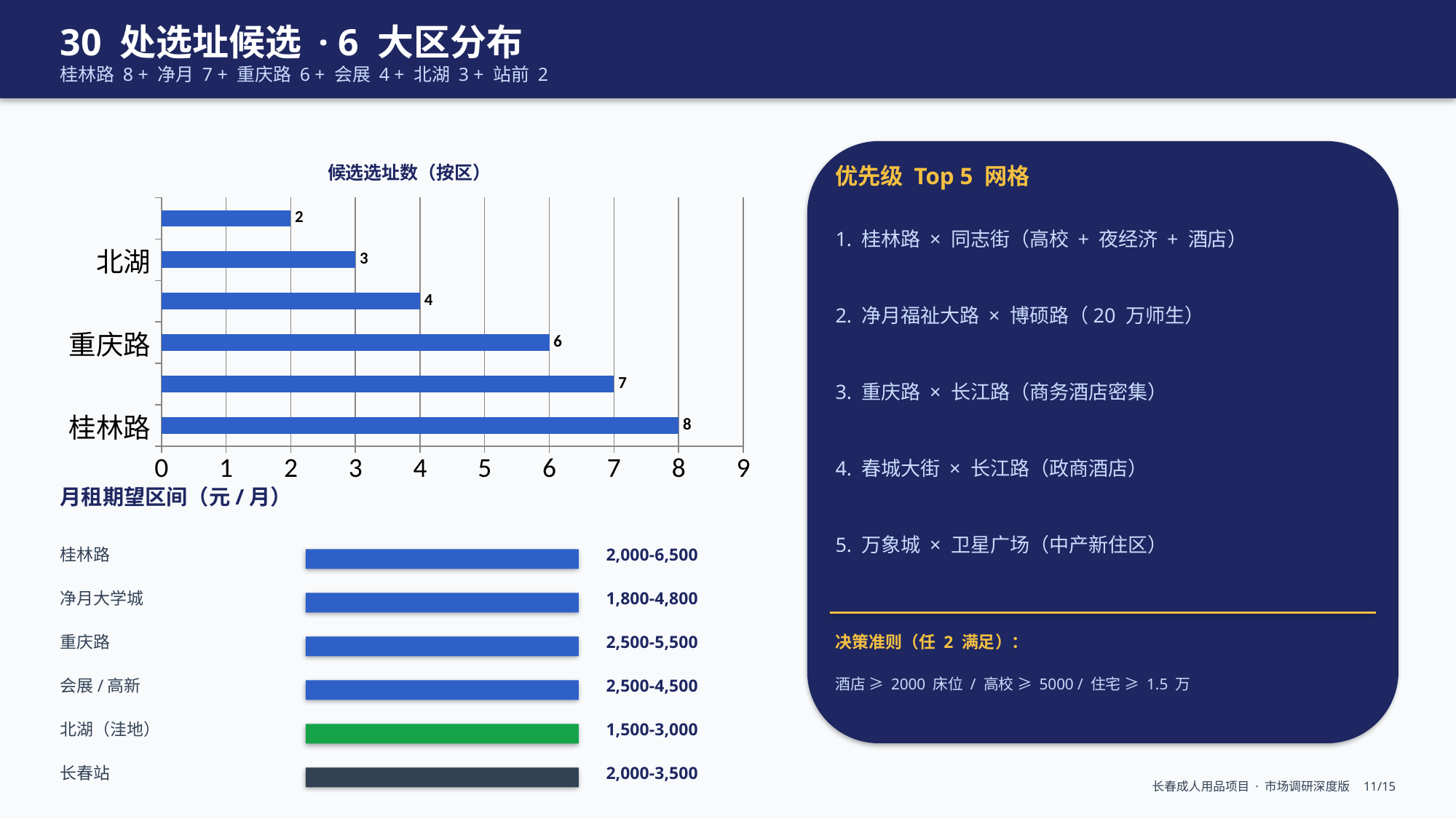
In the 候选选址数（按区） chart, which labeled district has the highest value? 桂林路 In the 候选选址数（按区） chart, what is the smallest value shown on any bar? 2 In the 月租期望区间（元 / 月） section below the chart, what range is shown for 桂林路? 2,000-6,500 What is the title of the bar chart on the left of the slide? 候选选址数（按区） In the 候选选址数（按区） chart, what is the value for 重庆路? 6 What kind of chart is the 候选选址数（按区） chart? bar chart In the 候选选址数（按区） chart, what is the difference between the values for 桂林路 and 重庆路? 2 In the 候选选址数（按区） chart, what is the value for 北湖? 3 In the 候选选址数（按区） chart, what is the difference between the values for 重庆路 and 北湖? 3 In the 候选选址数（按区） chart, which is larger, the value for 北湖 or the value for 重庆路? 重庆路 How many bars are plotted in the 候选选址数（按区） chart? 6 In the 候选选址数（按区） chart, what is the value for 桂林路? 8